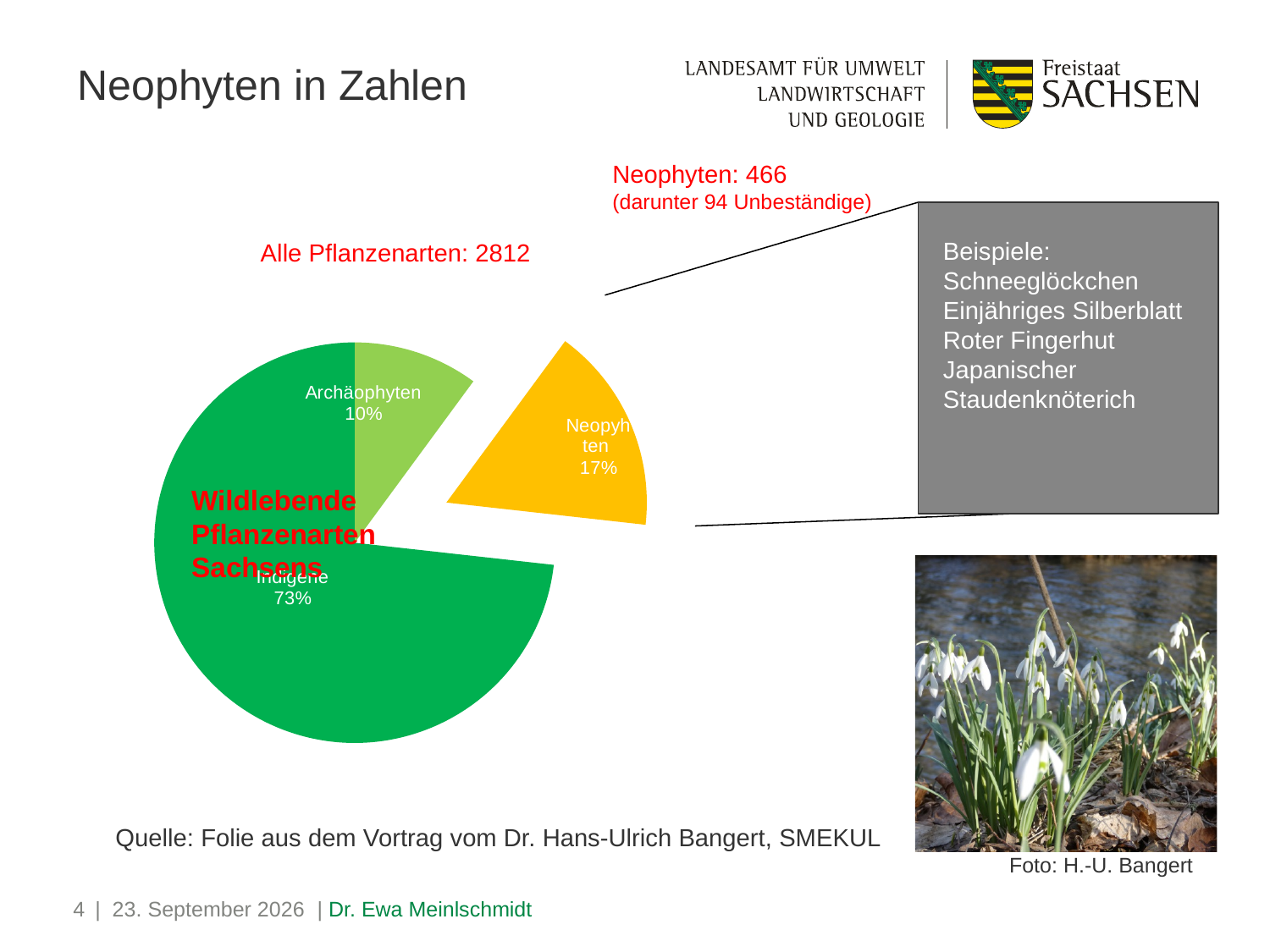
What share of the pie chart is labelled Archäophyten? 10% Which slice of the pie chart is the smallest? Archäophyten What is the title written in red over the pie chart? Wildlebende Pflanzenarten Sachsens What share of the pie chart is labelled Indigene? 73% Which slice is larger, Archäophyten or Neopyhten? Neopyhten How many slices does the pie chart have? 3 What is the difference in percentage points between the Indigene slice and the Neopyhten slice? 56 Which slice of the pie chart is pulled out (exploded) from the rest? Neopyhten What is the difference in percentage points between the Neopyhten slice and the Archäophyten slice? 7 What share of the pie chart is labelled Neopyhten? 17% What kind of chart is shown on the slide? pie chart Which slice of the pie chart is the largest? Indigene